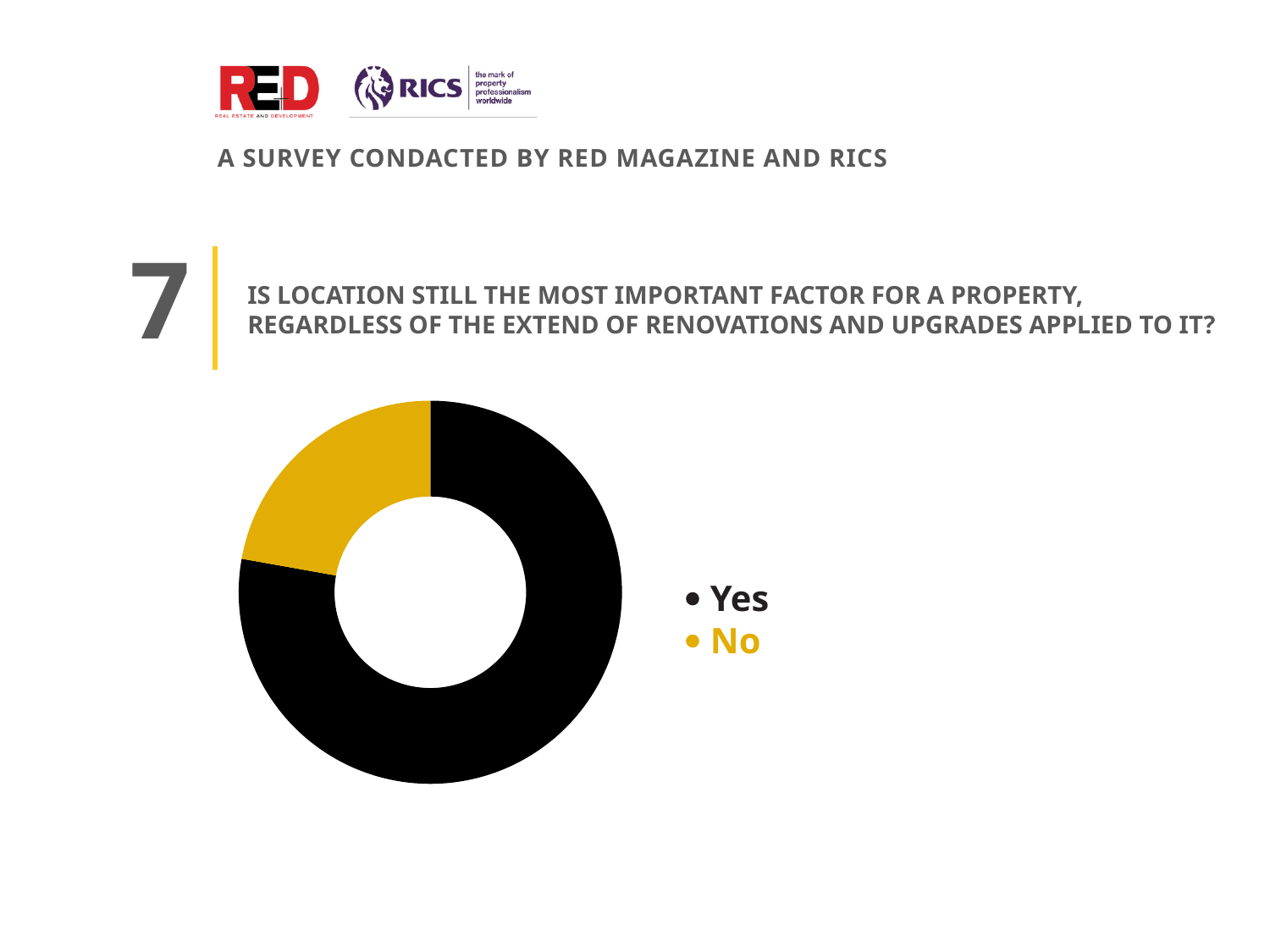
Which category has the smallest share of the chart? No What kind of chart is shown on the slide? doughnut chart How many entries does the chart's legend list? 2 What colour represents the No category in the chart? yellow Which category has the largest share of the chart? Yes Which response did the majority of survey respondents give to question 7? Yes How many categories does the chart show? 2 Which is larger in the chart, the share for Yes or the share for No? Yes What are the two legend entries of the chart? Yes and No